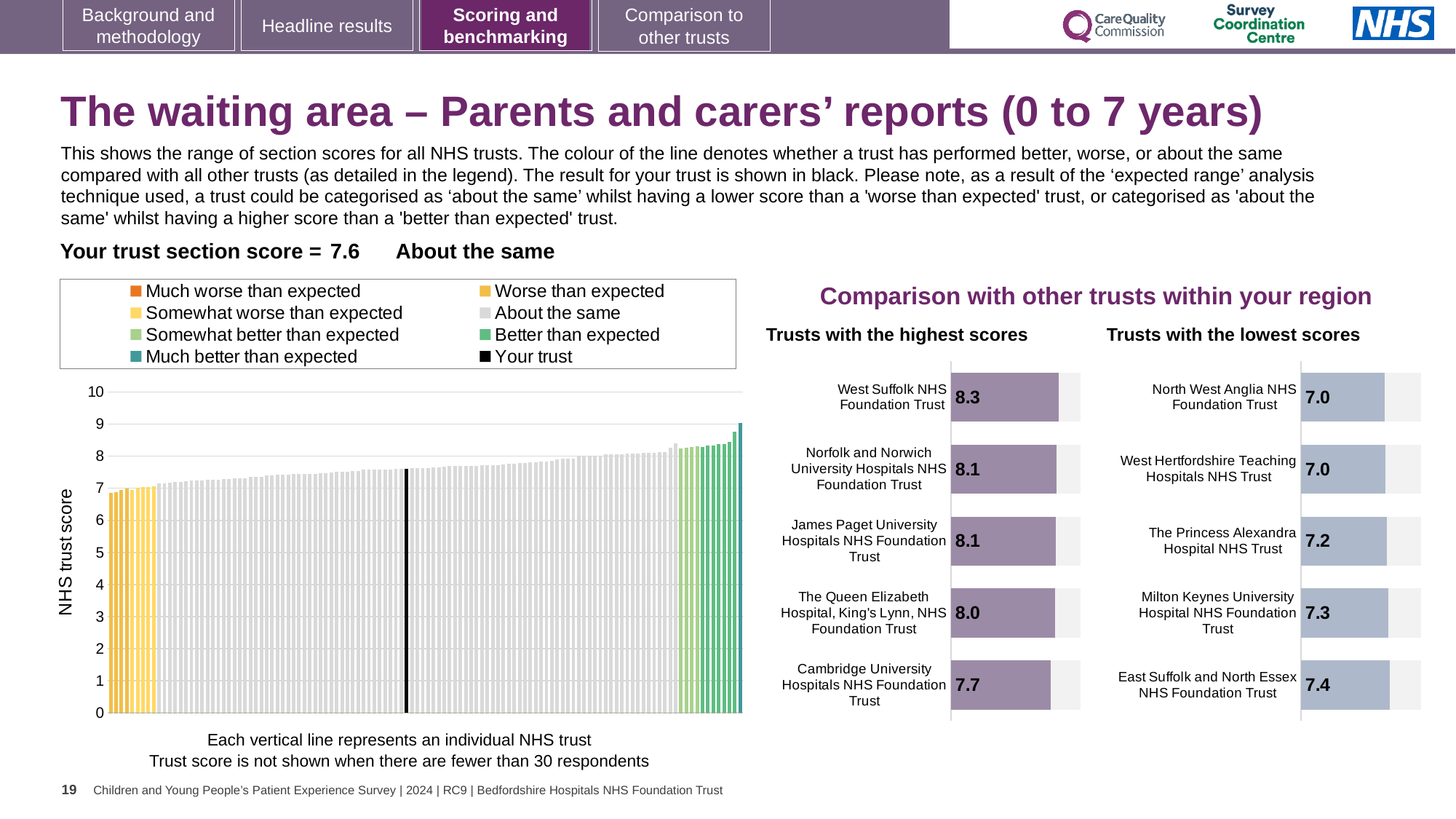
In the main chart on the left showing all NHS trusts, what is the section score for your trust (the black bar)? 7.6 In the 'Trusts with the highest scores' chart, how many trusts are shown? 5 In the 'Trusts with the highest scores' chart, what is the score for West Suffolk NHS Foundation Trust? 8.3 In the 'Trusts with the highest scores' chart, what is the difference between the scores of West Suffolk NHS Foundation Trust and Cambridge University Hospitals NHS Foundation Trust? 0.6 How many entries does the legend of the main chart on the left list? 8 In the 'Trusts with the lowest scores' chart, what is the difference between the scores of East Suffolk and North Essex NHS Foundation Trust and North West Anglia NHS Foundation Trust? 0.4 In the 'Trusts with the lowest scores' chart, what is the score for Milton Keynes University Hospital NHS Foundation Trust? 7.3 In the main chart on the left showing all NHS trusts, do the bar values rise or fall from left to right? rise In the 'Trusts with the highest scores' chart, which trust has the lowest score? Cambridge University Hospitals NHS Foundation Trust In the 'Trusts with the lowest scores' chart, which trust has the highest score? East Suffolk and North Essex NHS Foundation Trust In the 'Trusts with the lowest scores' chart, which has the larger score: The Princess Alexandra Hospital NHS Trust or Milton Keynes University Hospital NHS Foundation Trust? Milton Keynes University Hospital NHS Foundation Trust What type of chart is the main chart on the left showing all NHS trusts? bar chart